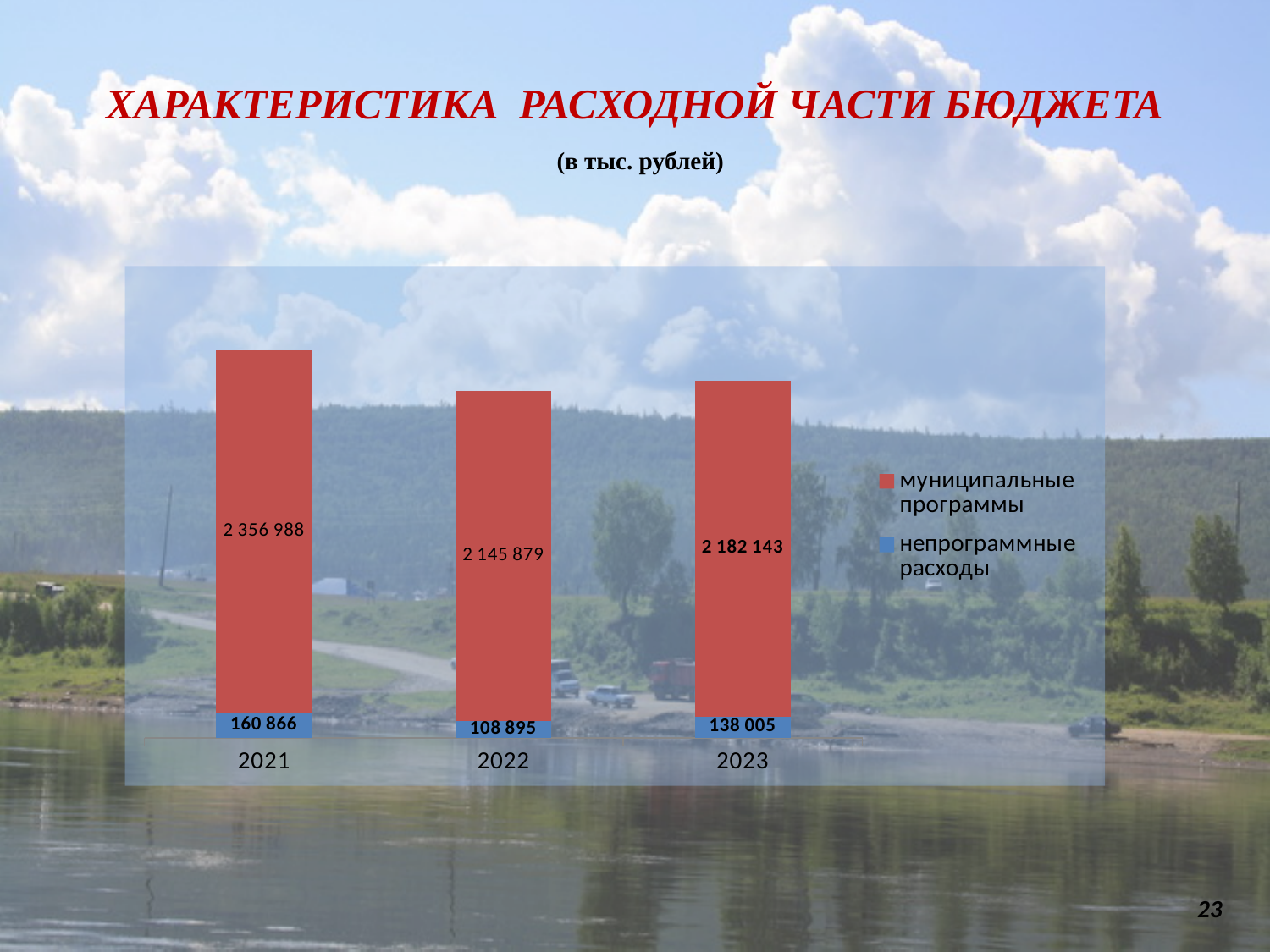
What is the difference between the непрограммные расходы values for 2021 and 2023? 22 861 What is the difference between the муниципальные программы values for 2021 and 2022? 211 109 What is the value for муниципальные программы in 2023? 2 182 143 In which year is the value for муниципальные программы the highest? 2021 What is the value for муниципальные программы in 2021? 2 356 988 What kind of chart is shown on the slide? Stacked bar chart In which year is the value for непрограммные расходы the lowest? 2022 How many years are shown on the x axis? 3 Which is larger: муниципальные программы in 2022 or in 2023? 2023 What is the total of the stacked bar for 2021? 2 517 854 How many series does the legend list? 2 What is the value for непрограммные расходы in 2022? 108 895